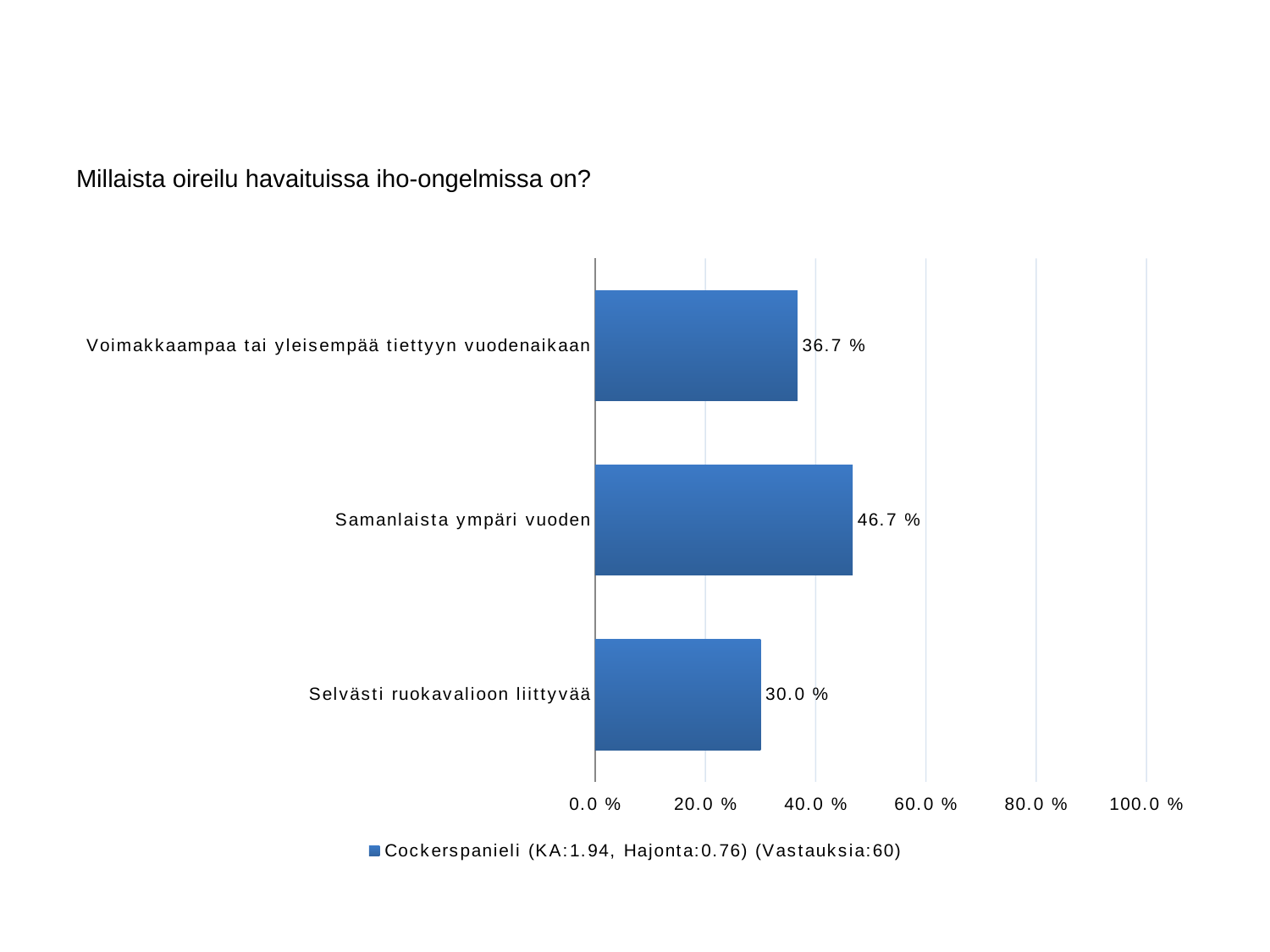
What is the value for "Samanlaista ympäri vuoden"? 46.7 % What is the value for "Voimakkaampaa tai yleisempää tiettyyn vuodenaikaan"? 36.7 % What kind of chart is shown on the slide? bar chart Is the value for "Samanlaista ympäri vuoden" greater or less than 40.0 %? greater Which category has the lowest value? Selvästi ruokavalioon liittyvää What is the value for "Selvästi ruokavalioon liittyvää"? 30.0 % How many categories are shown in the chart? 3 Which is larger: the value for "Voimakkaampaa tai yleisempää tiettyyn vuodenaikaan" or for "Selvästi ruokavalioon liittyvää"? Voimakkaampaa tai yleisempää tiettyyn vuodenaikaan Which category has the highest value? Samanlaista ympäri vuoden How many responses (Vastauksia) does the legend entry report? 60 What is the difference between the values for "Samanlaista ympäri vuoden" and "Voimakkaampaa tai yleisempää tiettyyn vuodenaikaan"? 10.0 % What is the difference between the values for "Samanlaista ympäri vuoden" and "Selvästi ruokavalioon liittyvää"? 16.7 %